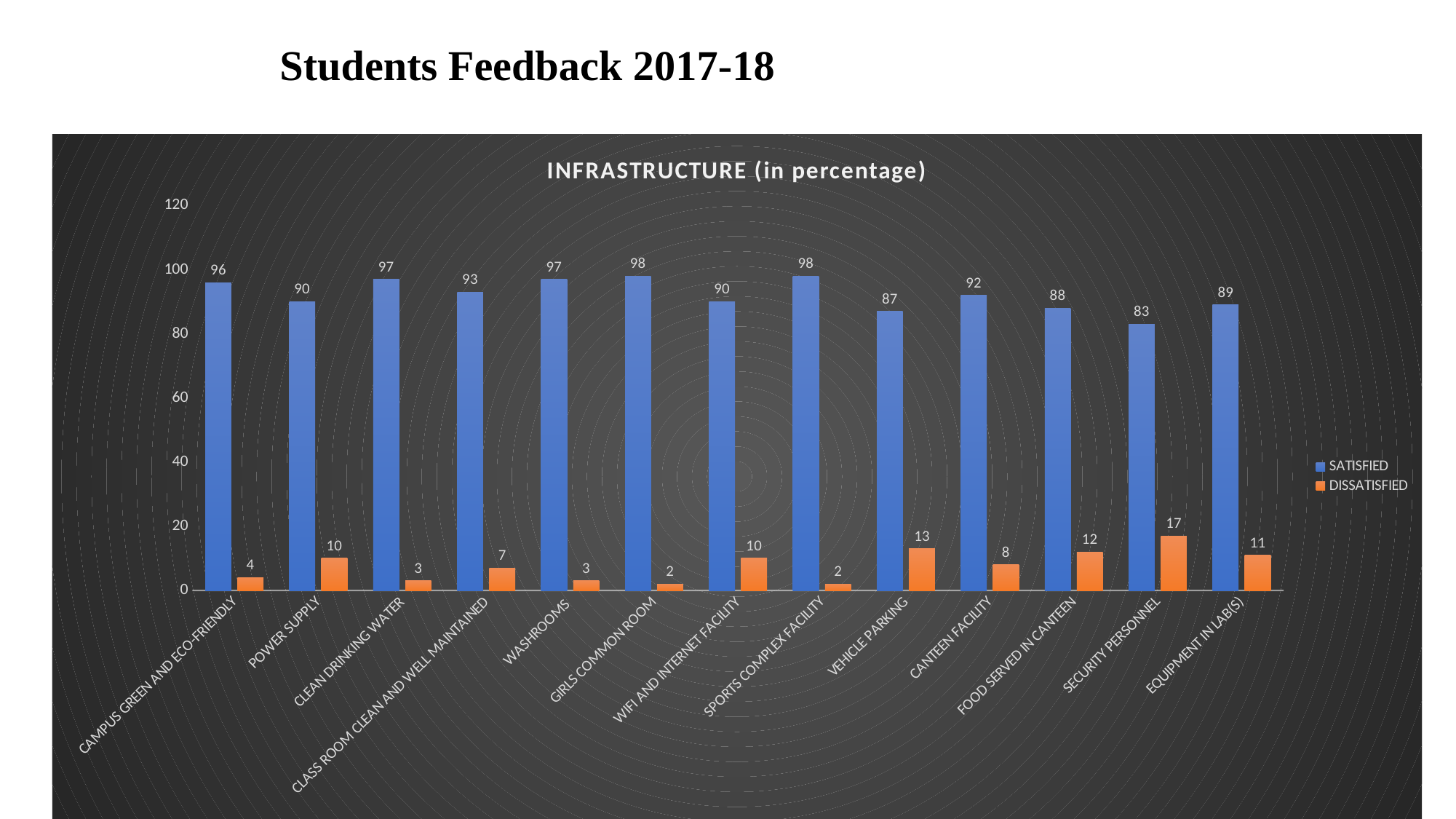
What is the SATISFIED value for CLASS ROOM CLEAN AND WELL MAINTAINED? 93 How many categories are shown on the x axis? 13 Which has a higher SATISFIED value, CANTEEN FACILITY or FOOD SERVED IN CANTEEN? CANTEEN FACILITY How many series does the legend list? 2 Is the SATISFIED value for EQUIPMENT IN LAB(S) greater or less than 100? less What is the SATISFIED value for SECURITY PERSONNEL? 83 What is the title of the chart? INFRASTRUCTURE (in percentage) What kind of chart is shown on the slide? bar chart What is the difference between the SATISFIED values for CAMPUS GREEN AND ECO-FRIENDLY and POWER SUPPLY? 6 Which category has the highest DISSATISFIED value? SECURITY PERSONNEL Which category has the lowest SATISFIED value? SECURITY PERSONNEL What is the DISSATISFIED value for VEHICLE PARKING? 13